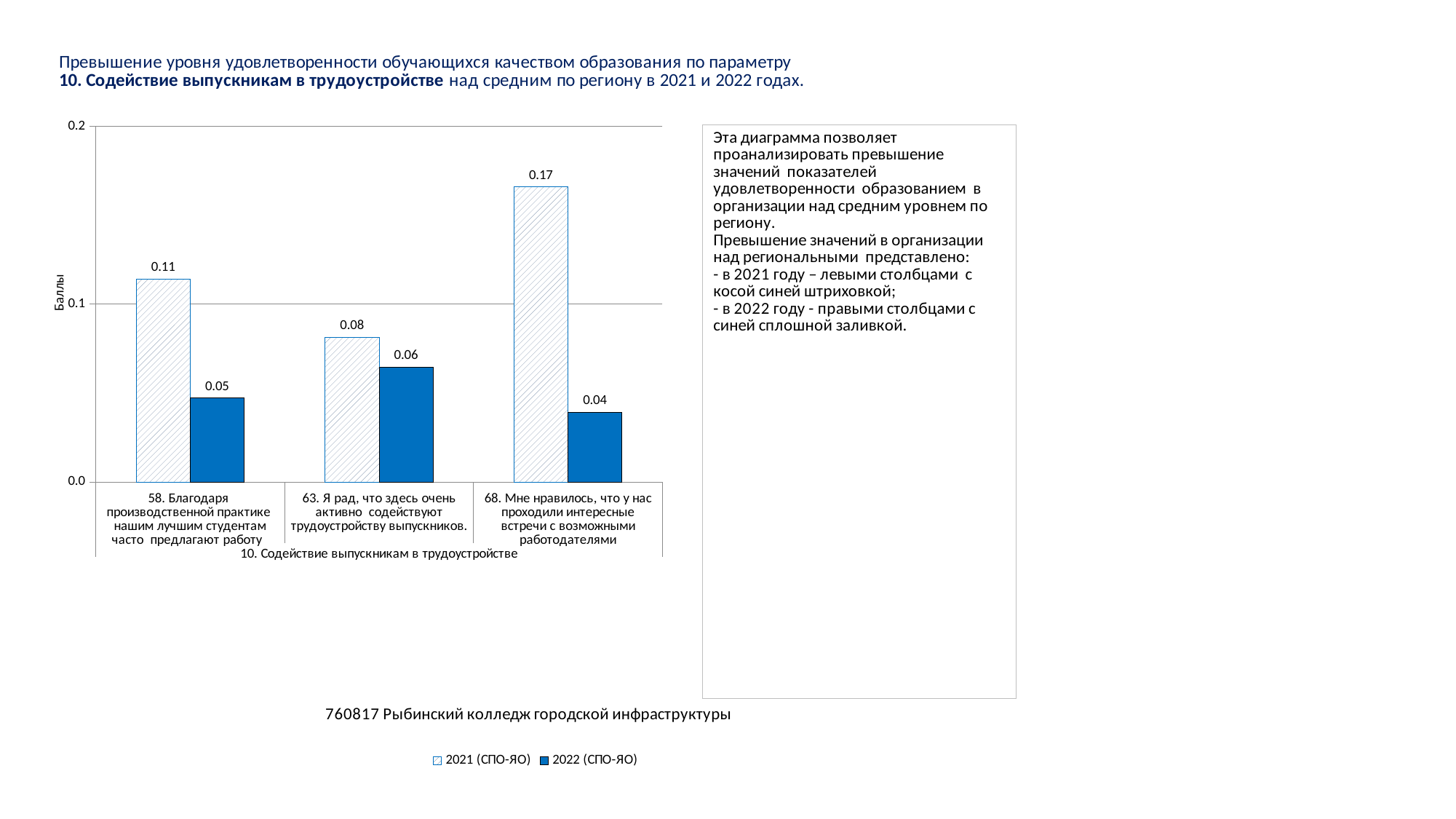
What is the 2021 (СПО-ЯО) value for category 58 (Благодаря производственной практике нашим лучшим студентам часто предлагают работу)? 0.11 What is the 2022 (СПО-ЯО) value for category 68? 0.04 What is the 2022 (СПО-ЯО) value for category 63 (Я рад, что здесь очень активно содействуют трудоустройству выпускников)? 0.06 How many series does the legend list? 2 Which category has the highest 2021 (СПО-ЯО) value? 68. Мне нравилось, что у нас проходили интересные встречи с возможными работодателями How many categories are shown on the x axis? 3 What is the difference between the 2021 and 2022 values for category 68? 0.13 Which is larger for category 63: the 2021 (СПО-ЯО) value or the 2022 (СПО-ЯО) value? 2021 (СПО-ЯО) Which category has the lowest 2022 (СПО-ЯО) value? 68. Мне нравилось, что у нас проходили интересные встречи с возможными работодателями Is the 2021 (СПО-ЯО) value for category 68 greater or less than 0.1? greater What is the 2021 (СПО-ЯО) value for category 68 (Мне нравилось, что у нас проходили интересные встречи с возможными работодателями)? 0.17 What kind of chart is shown on the slide? bar chart